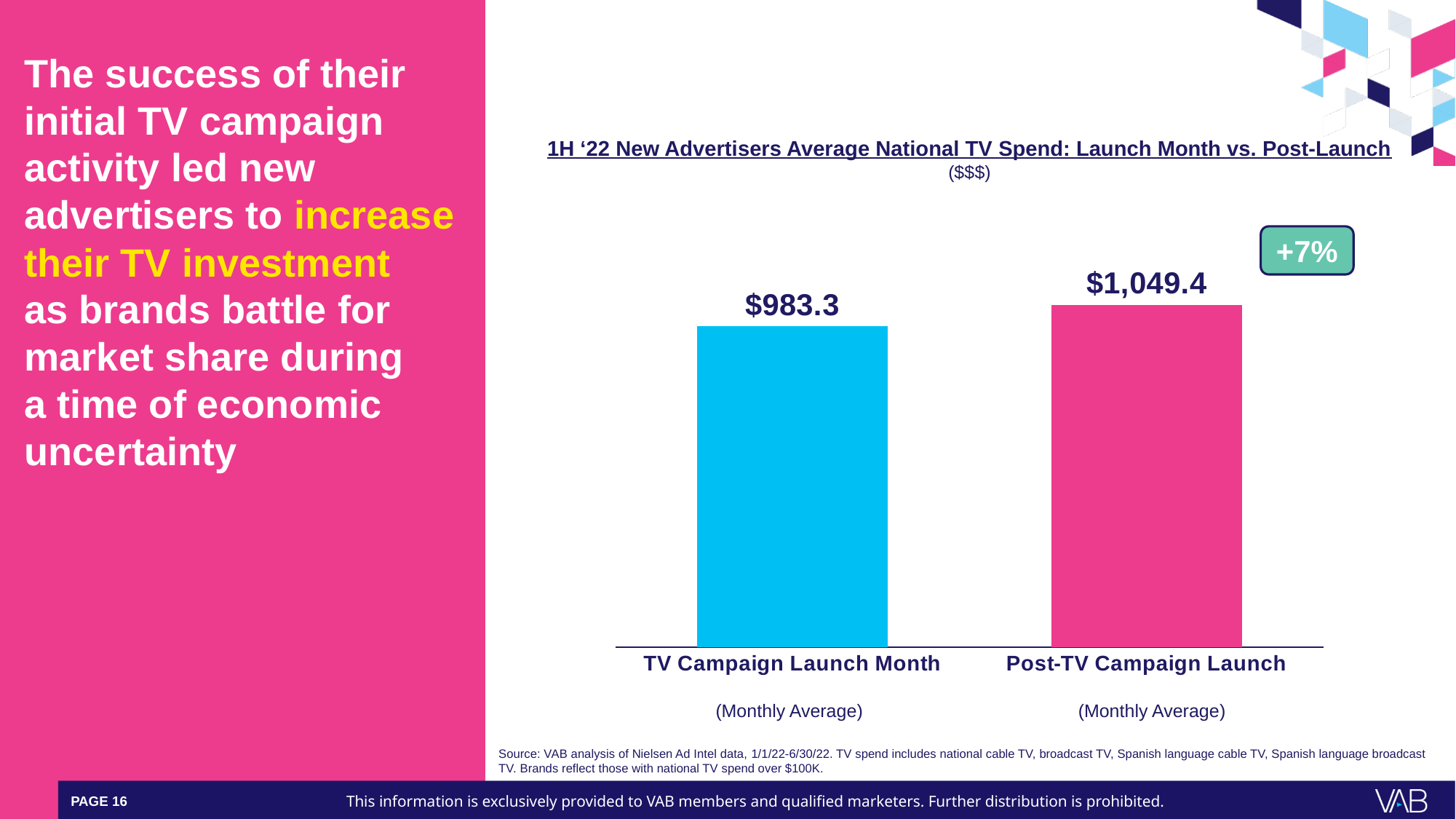
What percentage change is shown in the callout next to the Post-TV Campaign Launch bar? +7% What is the average national TV spend for Post-TV Campaign Launch? $1,049.4 Is the value for Post-TV Campaign Launch larger or smaller than the value for TV Campaign Launch Month? larger How many categories are shown in the chart? 2 What kind of chart is shown on the slide? bar chart Which category has the higher average national TV spend? Post-TV Campaign Launch What is the average national TV spend for TV Campaign Launch Month? $983.3 What is the title of the chart? 1H '22 New Advertisers Average National TV Spend: Launch Month vs. Post-Launch Do the values rise or fall from TV Campaign Launch Month to Post-TV Campaign Launch? rise Which category has the lower average national TV spend? TV Campaign Launch Month What is the difference between the Post-TV Campaign Launch and TV Campaign Launch Month values? $66.1